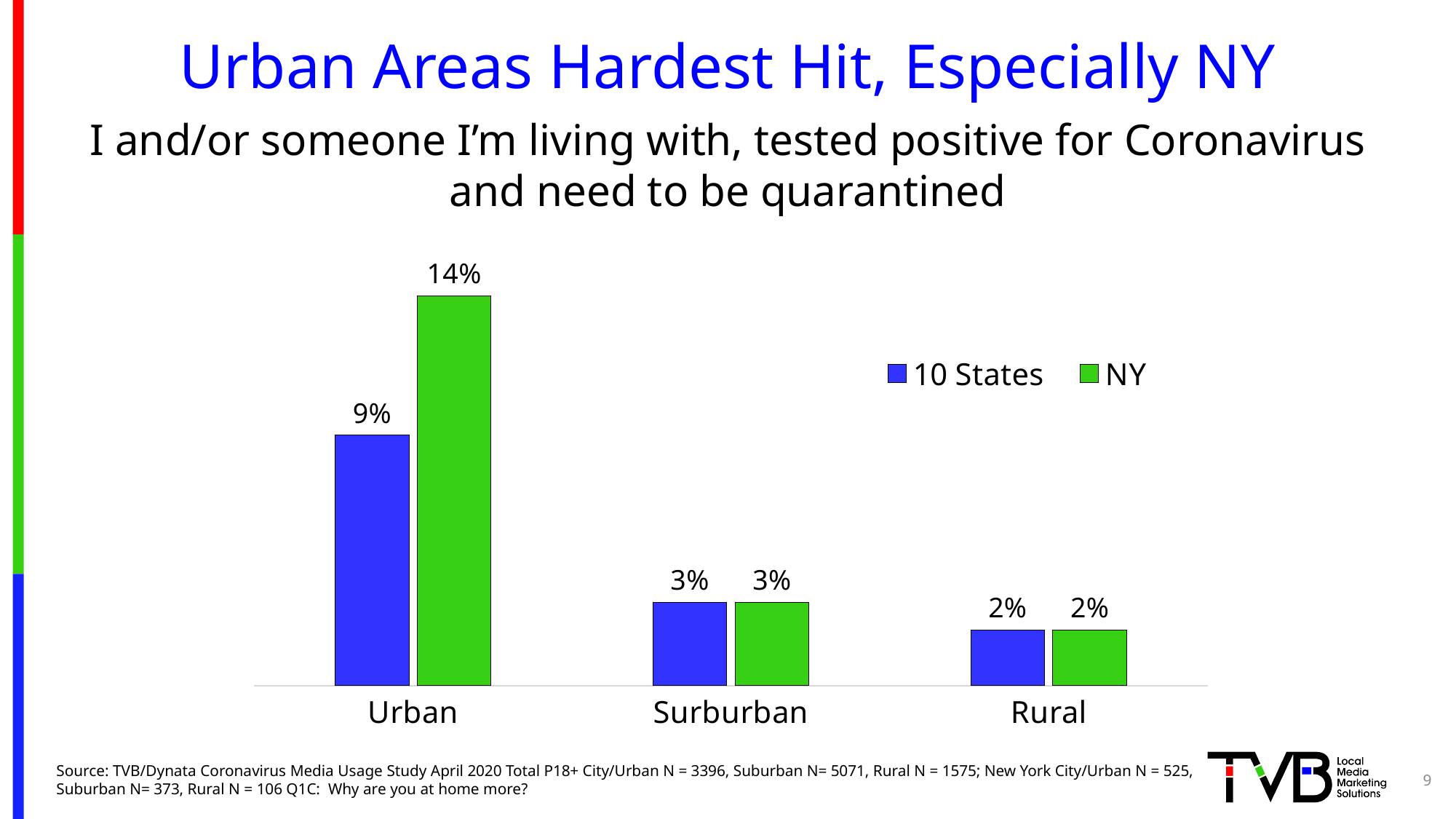
What is the value for 10 States in the Urban category? 9% What kind of chart is shown on the slide? Bar chart Which category has the lowest value for the 10 States series? Rural What is the value for NY in the Surburban category? 3% What is the value for NY in the Urban category? 14% What is the difference between the NY and 10 States values in the Urban category? 5% What is the value for 10 States in the Rural category? 2% Which category has the highest value for the NY series? Urban In the Urban category, which series has the larger value, 10 States or NY? NY How many series does the legend list? 2 How many categories are shown on the x axis? 3 Which series is shown in green in the legend? NY